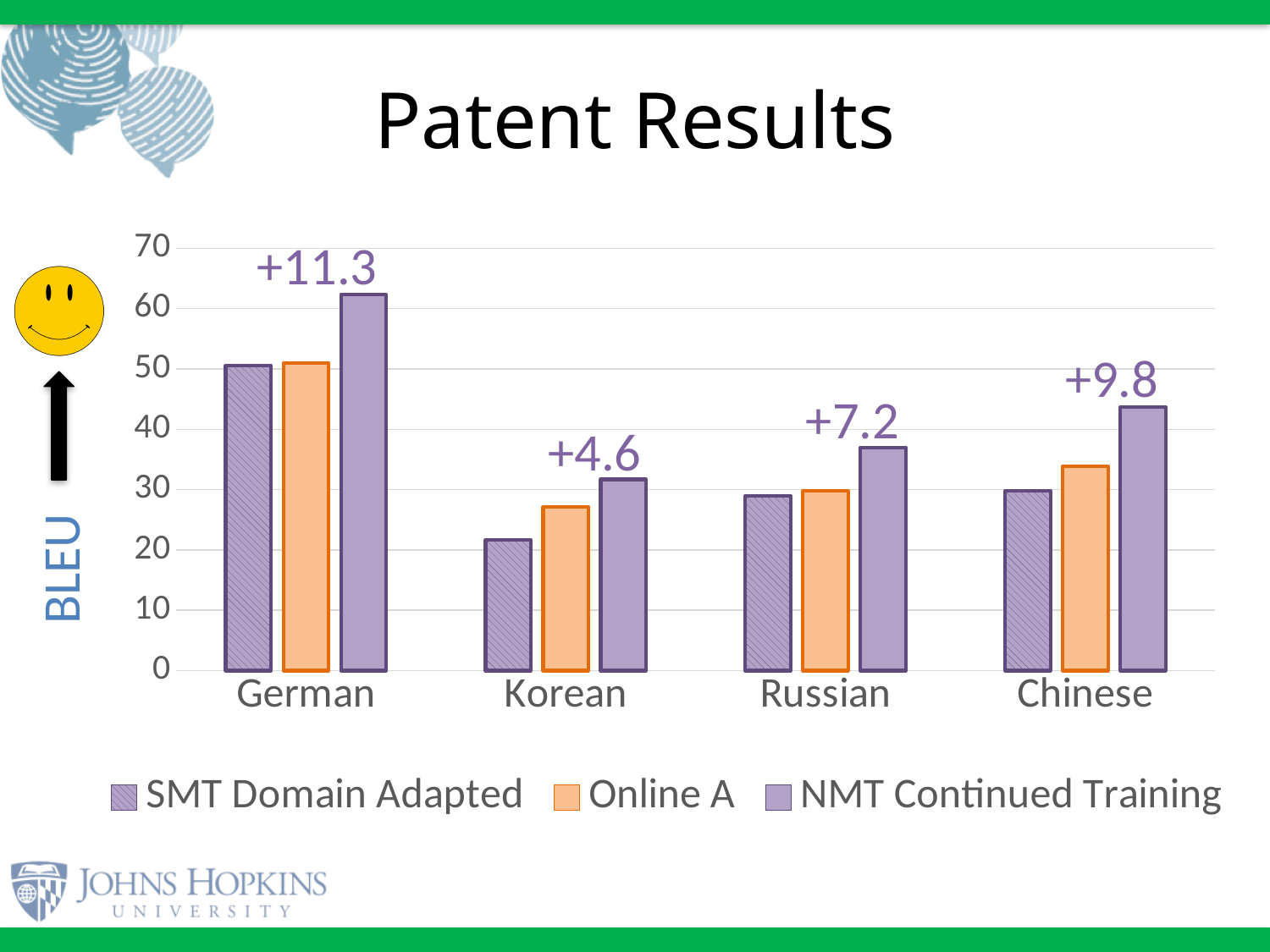
What improvement value is printed above the Chinese bars? +9.8 What improvement value is printed above the Korean bars? +4.6 How many languages are shown on the x axis of the chart? 4 What kind of chart is shown on the slide? bar chart What is the label of the y axis? BLEU Which language has the highest NMT Continued Training bar? German What improvement value is printed above the German bars? +11.3 Is the NMT Continued Training value for German greater or less than 60? greater Which language has the largest printed improvement value? German Which language has the lowest SMT Domain Adapted bar? Korean How many series does the legend list? 3 Is the NMT Continued Training value for Russian greater or less than 40? less